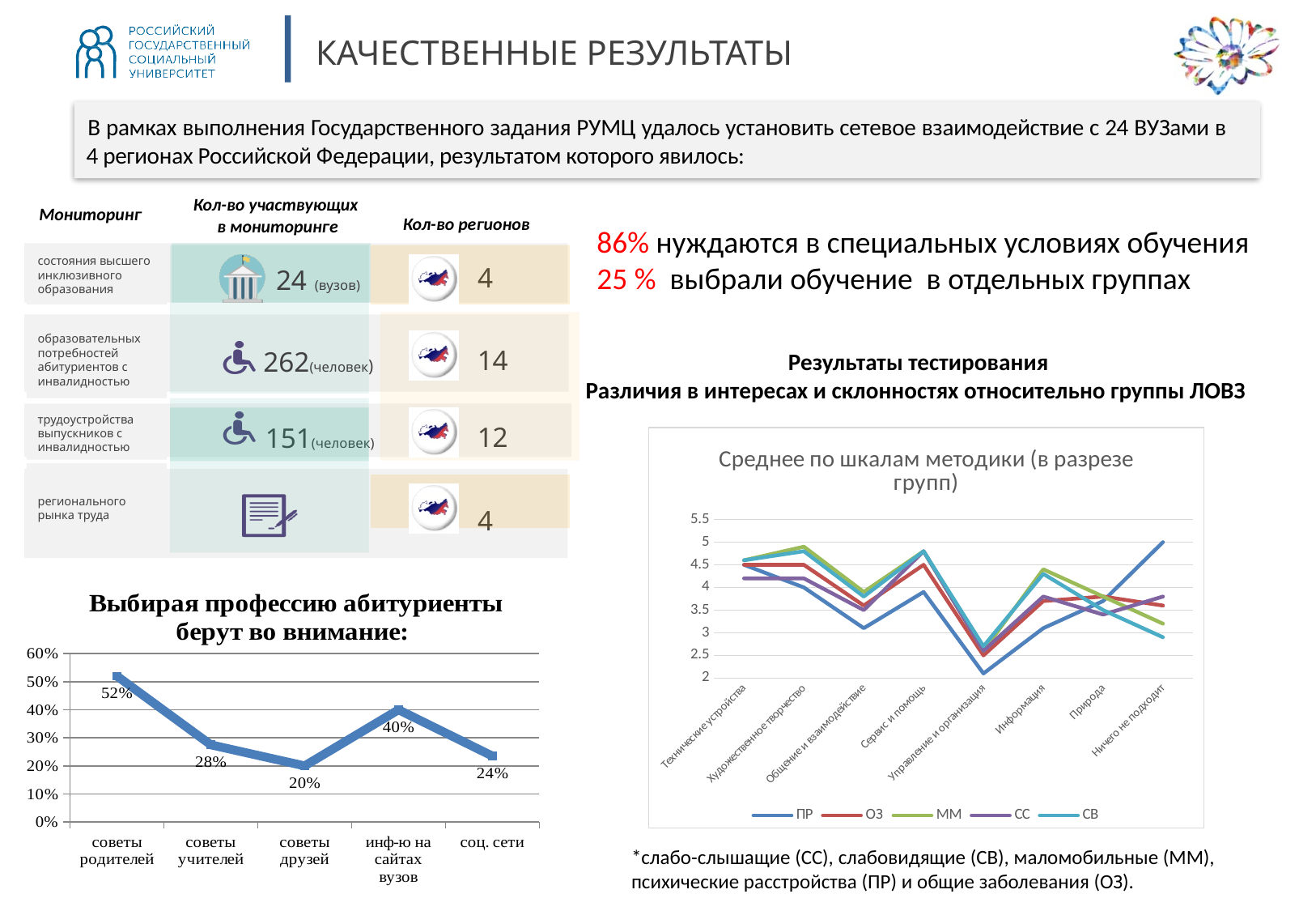
On the chart 'Выбирая профессию абитуриенты берут во внимание:', which category has the highest value? советы родителей How many categories are shown on the chart 'Выбирая профессию абитуриенты берут во внимание:'? 5 What kind of chart is 'Среднее по шкалам методики (в разрезе групп)'? line chart On the chart 'Выбирая профессию абитуриенты берут во внимание:', which is larger: 'советы учителей' or 'соц. сети'? советы учителей On the chart 'Выбирая профессию абитуриенты берут во внимание:', what is the difference between 'советы родителей' and 'соц. сети'? 28% On the chart 'Выбирая профессию абитуриенты берут во внимание:', which category has the lowest value? советы друзей How many series does the legend of the chart 'Среднее по шкалам методики (в разрезе групп)' list? 5 How many categories are shown on the x axis of the chart 'Среднее по шкалам методики (в разрезе групп)'? 8 On the chart 'Выбирая профессию абитуриенты берут во внимание:', what is the value for 'инф-ю на сайтах вузов'? 40% On the chart 'Выбирая профессию абитуриенты берут во внимание:', what is the value for 'советы родителей'? 52% On the chart 'Среднее по шкалам методики (в разрезе групп)', is the value of the ПР series for 'Ничего не подходит' greater or less than 4.5? greater On the chart 'Среднее по шкалам методики (в разрезе групп)', is the value of the ПР series for 'Управление и организация' greater or less than 2.5? less